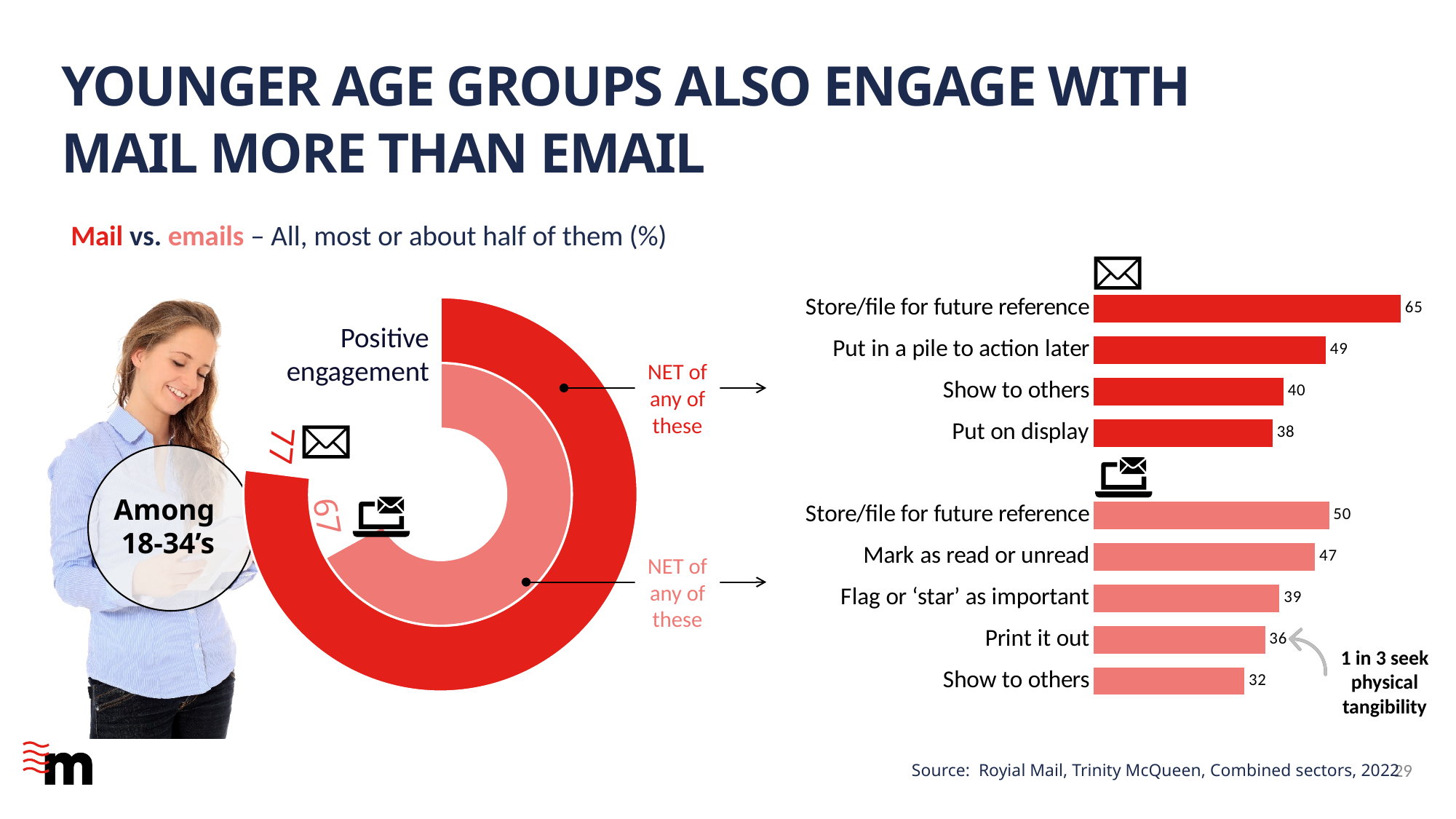
In the email bar chart on the right (bottom), what is the value for 'Print it out'? 36 In the radial chart on the left, what is the positive engagement value for mail among 18-34's? 77 In the mail bar chart on the right (top), what is the difference between 'Store/file for future reference' and 'Put in a pile to action later'? 16 In the mail bar chart on the right (top), which category has the highest value? Store/file for future reference How many categories are shown in the mail bar chart on the right (top)? 4 What type of chart is used on the right side of the slide? Bar chart In the email bar chart on the right (bottom), which category has the lowest value? Show to others In the mail bar chart on the right (top), what is the value for 'Store/file for future reference'? 65 How many categories are shown in the email bar chart on the right (bottom)? 5 In the radial chart on the left, what is the difference between the mail value and the email value? 10 In the email bar chart on the right (bottom), what is the value for 'Mark as read or unread'? 47 Comparing the two bar charts on the right, which is larger: 'Show to others' for mail or 'Show to others' for email? Show to others for mail (40)